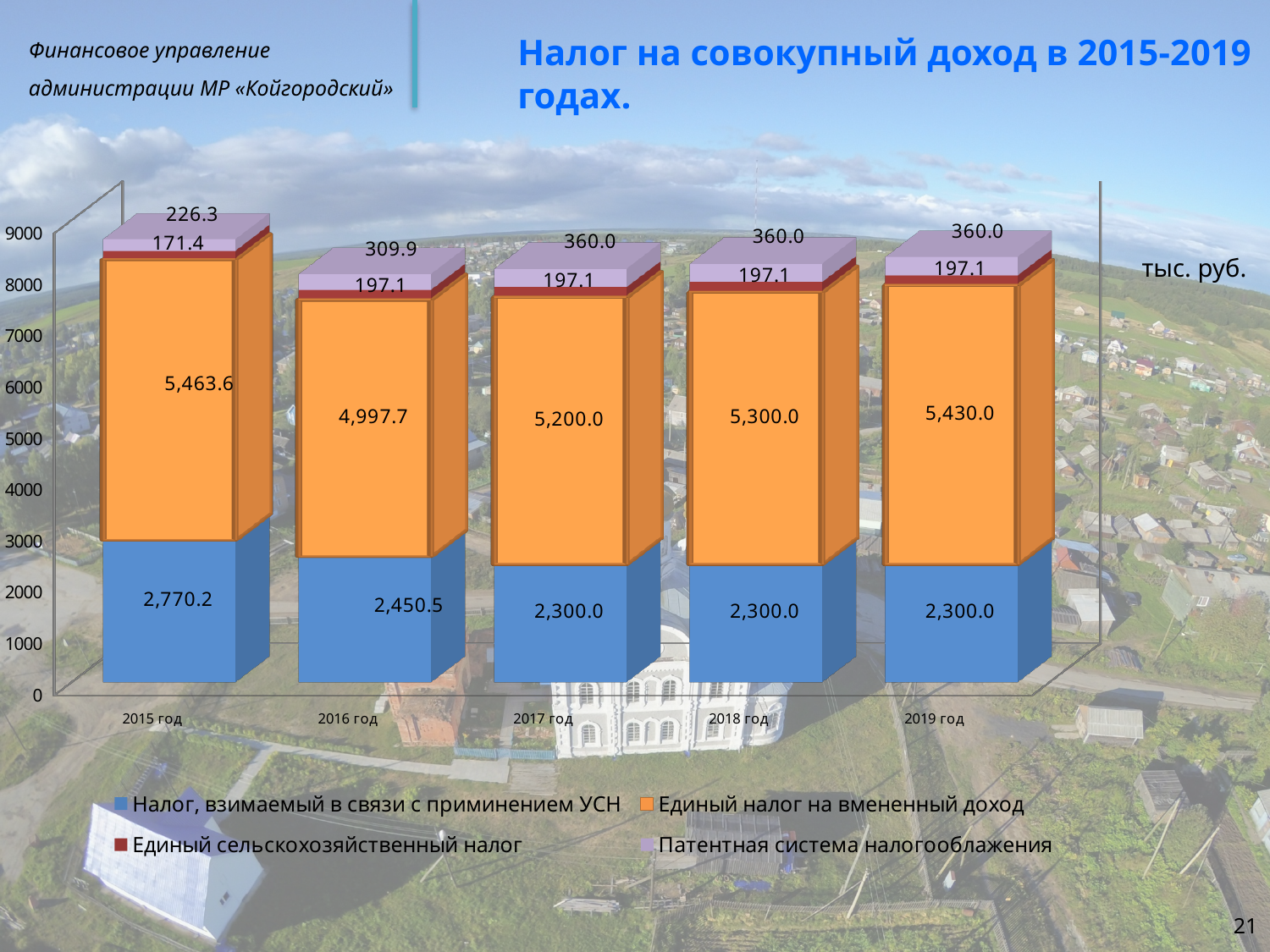
What is the total of the stacked bar for 2017 год? 8,057.1 What is the value of "Единый налог на вмененный доход" for 2019 год? 5,430.0 How many series does the legend list? 4 What is the value of "Единый сельскохозяйственный налог" for 2015 год? 171.4 What is the value of "Патентная система налогооблажения" for 2016 год? 309.9 What is the value of "Налог, взимаемый в связи с приминением УСН" for 2015 год? 2,770.2 Which is larger: "Налог, взимаемый в связи с приминением УСН" in 2015 год or in 2016 год? 2015 год In which year is "Единый налог на вмененный доход" the highest? 2015 год In which year is "Единый налог на вмененный доход" the lowest? 2016 год What kind of chart is shown on the slide? Stacked bar chart What is the difference between the "Единый налог на вмененный доход" values for 2019 год and 2018 год? 130.0 How many years are shown on the x axis? 5